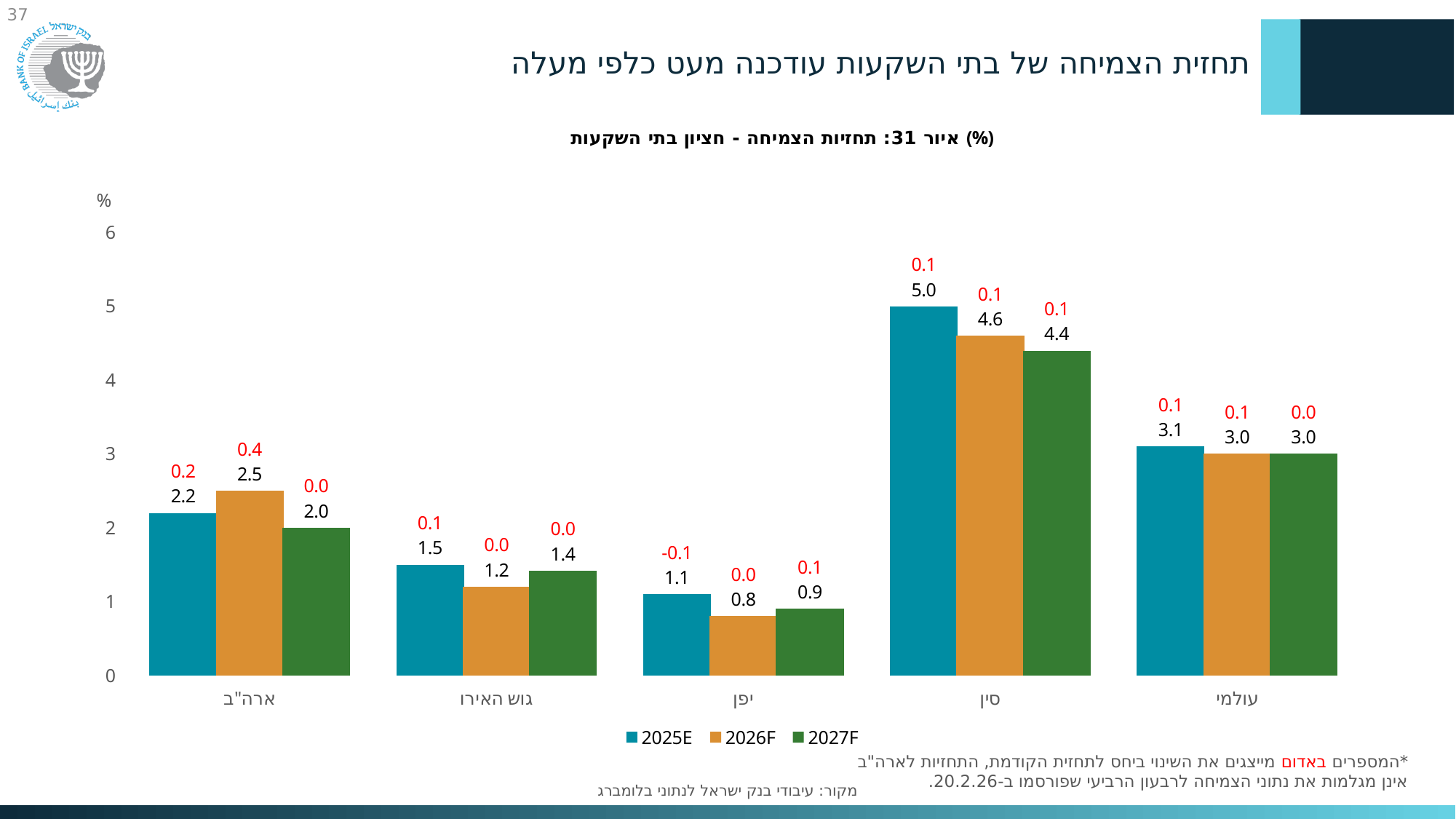
What is the 2026F value for ארה"ב? 2.5 What kind of chart is shown on the slide? bar chart What is the 2025E value for סין? 5.0 How many categories are shown on the x axis? 5 How many series does the legend list? 3 Which category has the lowest 2026F value? יפן What is the 2027F value for יפן? 0.9 Which is larger: the 2026F value for גוש האירו or the 2027F value for גוש האירו? 2027F What is the difference between the 2025E and 2027F values for סין? 0.6 Which category has the highest 2025E value? סין What is the red number shown above the 2026F bar for ארה"ב? 0.4 Is the 2025E value for עולמי greater or less than 3? greater